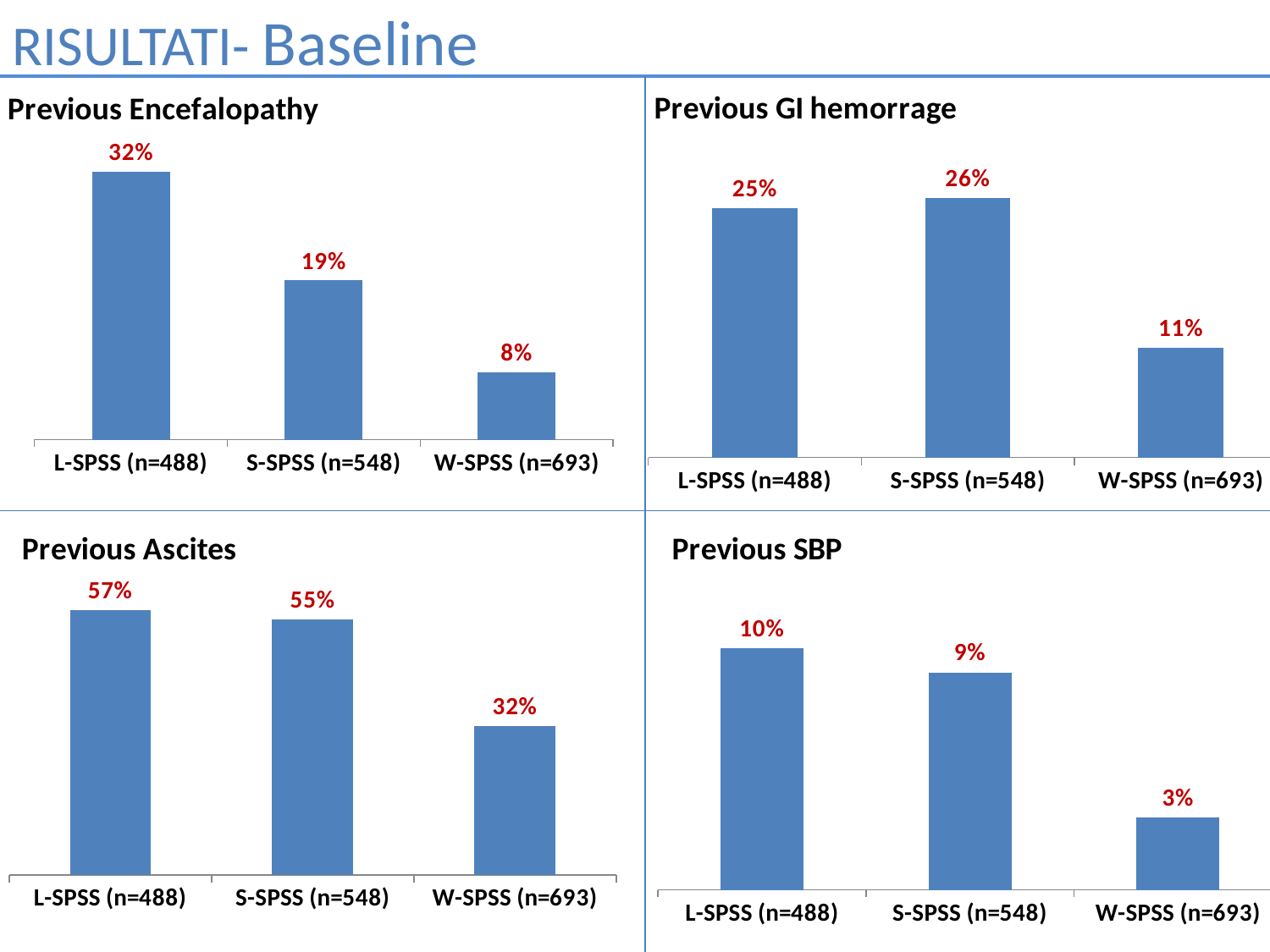
In the Previous GI hemorrage chart, which category has the highest value? S-SPSS (n=548) In the Previous GI hemorrage chart, what colour are the bars? Blue In the Previous SBP chart, what is the value for W-SPSS (n=693)? 3% In the Previous Encefalopathy chart, which category has the lowest value? W-SPSS (n=693) In the Previous SBP chart, what is the difference between the values for L-SPSS (n=488) and S-SPSS (n=548)? 1% In the Previous Ascites chart, what is the value for S-SPSS (n=548)? 55% In the Previous GI hemorrage chart, what is the value for W-SPSS (n=693)? 11% In the Previous Ascites chart, what is the difference between the values for L-SPSS (n=488) and W-SPSS (n=693)? 25% How many categories are shown in the Previous SBP chart? 3 In the Previous Encefalopathy chart, what is the value for L-SPSS (n=488)? 32% What kind of chart is the Previous Ascites chart? Bar chart In the Previous Encefalopathy chart, which is larger: the value for S-SPSS (n=548) or W-SPSS (n=693)? S-SPSS (n=548)